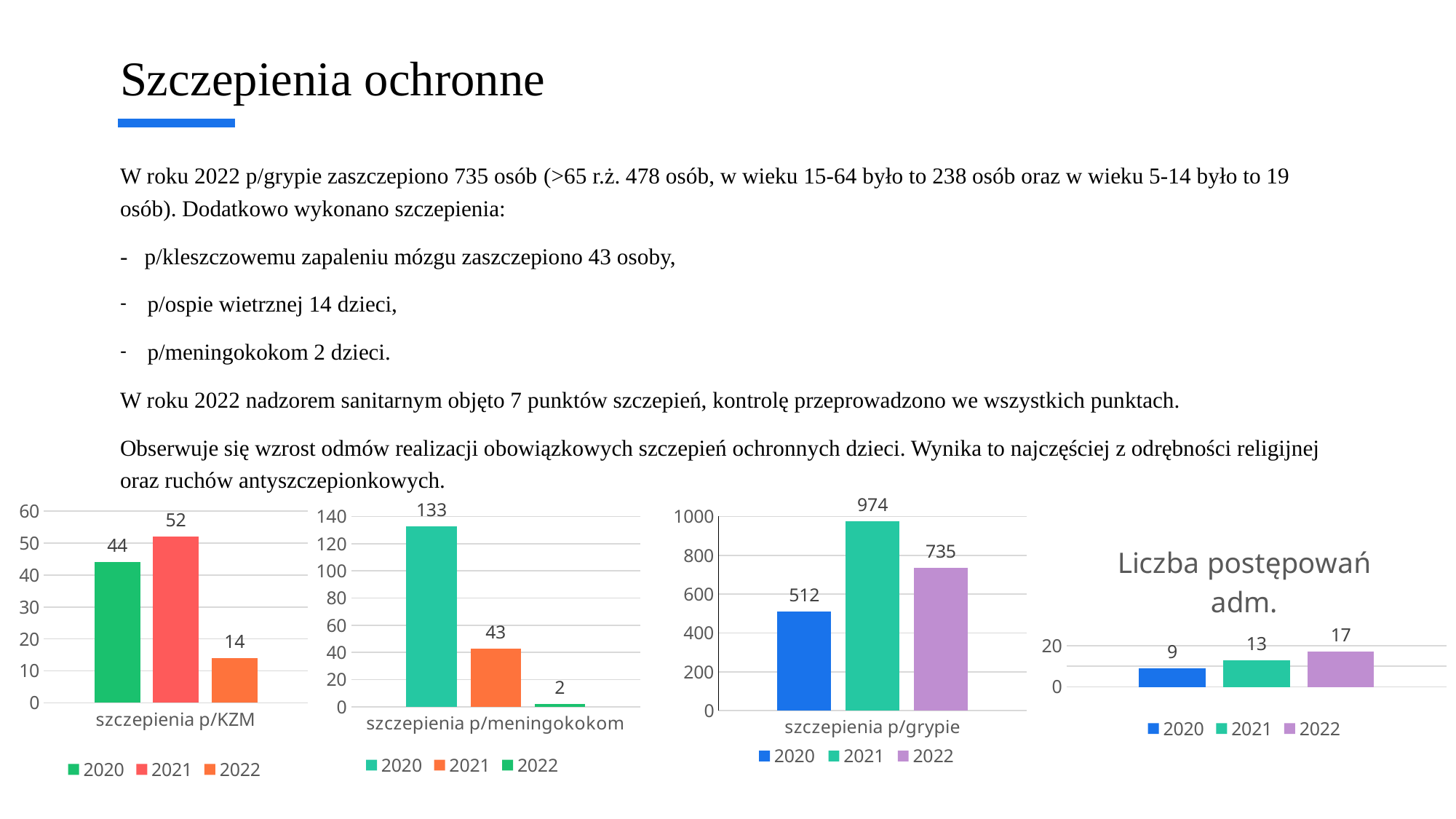
In the 'Liczba postępowań adm.' chart, what is the value for 2022? 17 In the 'szczepienia p/KZM' chart, which year has the lowest value? 2022 In the 'Liczba postępowań adm.' chart, do the values rise or fall from 2020 to 2022? rise In the 'szczepienia p/KZM' chart, what is the difference between the 2021 and 2020 values? 8 In the 'szczepienia p/meningokokom' chart, which year has the highest value? 2020 In the 'szczepienia p/meningokokom' chart, what is the value for 2020? 133 In the 'szczepienia p/KZM' chart, what is the value for 2021? 52 How many series does the legend of the 'szczepienia p/grypie' chart list? 3 In the 'szczepienia p/meningokokom' chart, do the values rise or fall from 2020 to 2022? fall In the 'szczepienia p/grypie' chart, what is the difference between the 2021 and 2022 values? 239 In the 'szczepienia p/grypie' chart, what is the value for 2021? 974 In the 'szczepienia p/grypie' chart, which is larger, the value for 2020 or the value for 2022? 2022